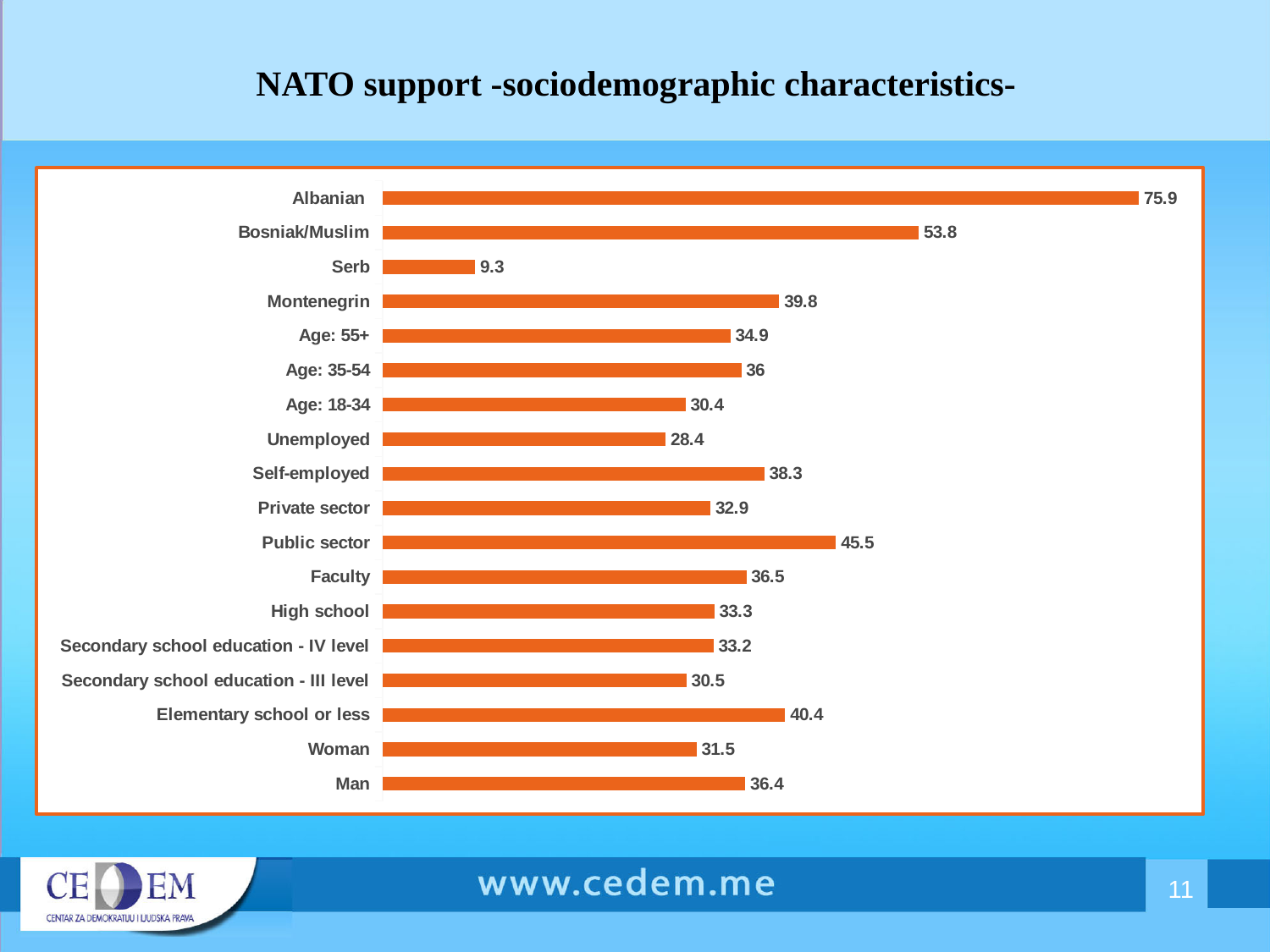
What is the title of the slide? NATO support -sociodemographic characteristics- Which is larger, the value for Self-employed or the value for Unemployed? Self-employed What is the difference between the values for Albanian and Bosniak/Muslim? 22.1 Which is larger, the value for Age: 35-54 or the value for Age: 18-34? Age: 35-54 What is the value for Public sector? 45.5 What is the value for Albanian? 75.9 What is the value for Woman? 31.5 What is the difference between the values for Man and Woman? 4.9 Which category has the highest value? Albanian How many categories are shown in the chart? 18 Which category has the lowest value? Serb What kind of chart is shown on the slide? Bar chart